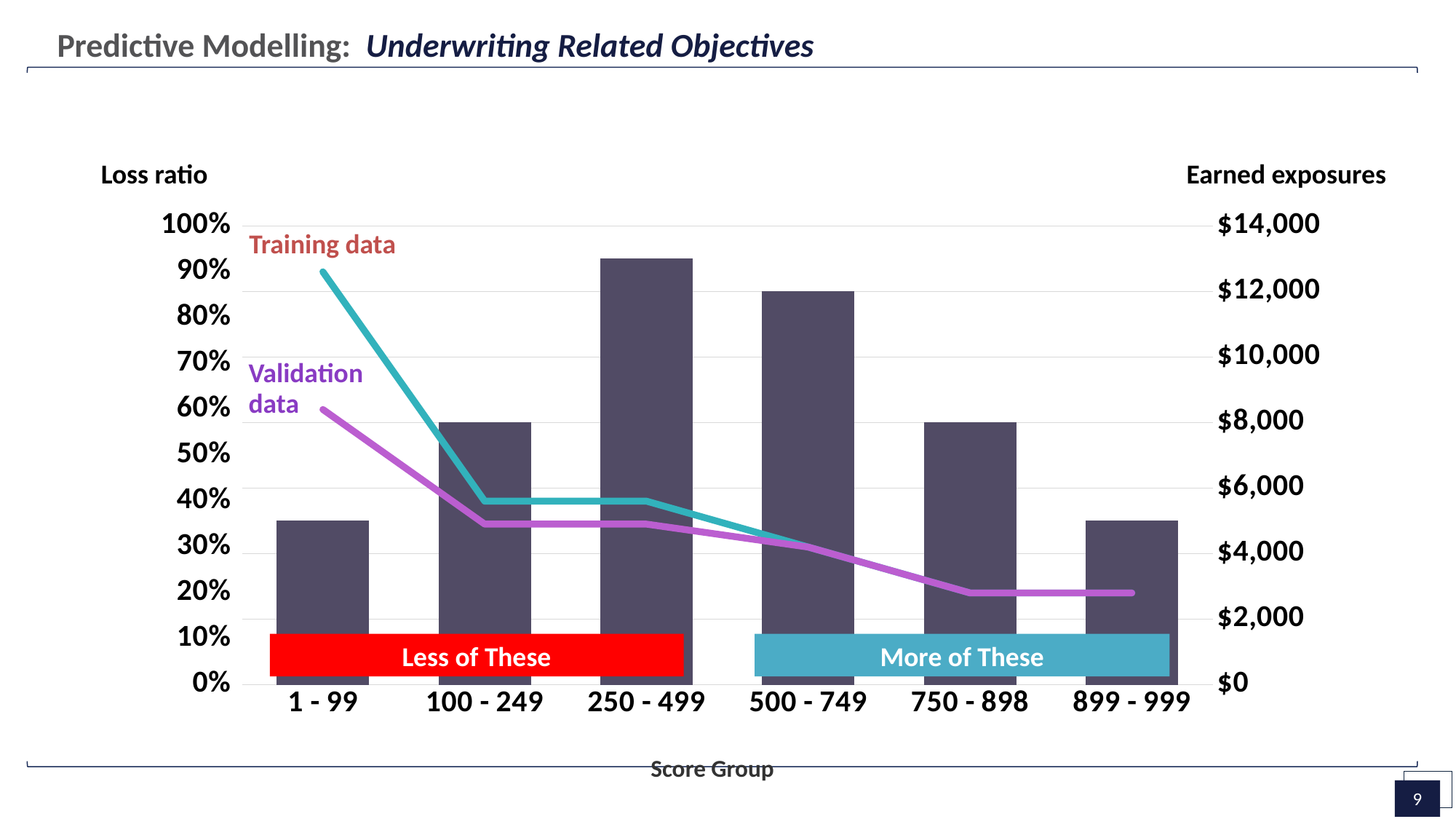
Which score group has the highest earned exposures bar? 250 - 499 Is the training data loss ratio for the 1 - 99 score group greater or less than 80%? greater Is the earned exposures value for the 250 - 499 score group greater or less than $12,000? greater Is the validation data loss ratio for the 899 - 999 score group greater or less than 30%? less What kind of chart is shown on the slide? A combined bar and line chart How many score groups are shown on the x axis? 6 For the 1 - 99 score group, which line has the higher loss ratio, training data or validation data? Training data What is the label of the right-hand vertical axis? Earned exposures Which score group has the highest validation data loss ratio? 1 - 99 Does the validation data loss ratio rise or fall as the score group increases? fall